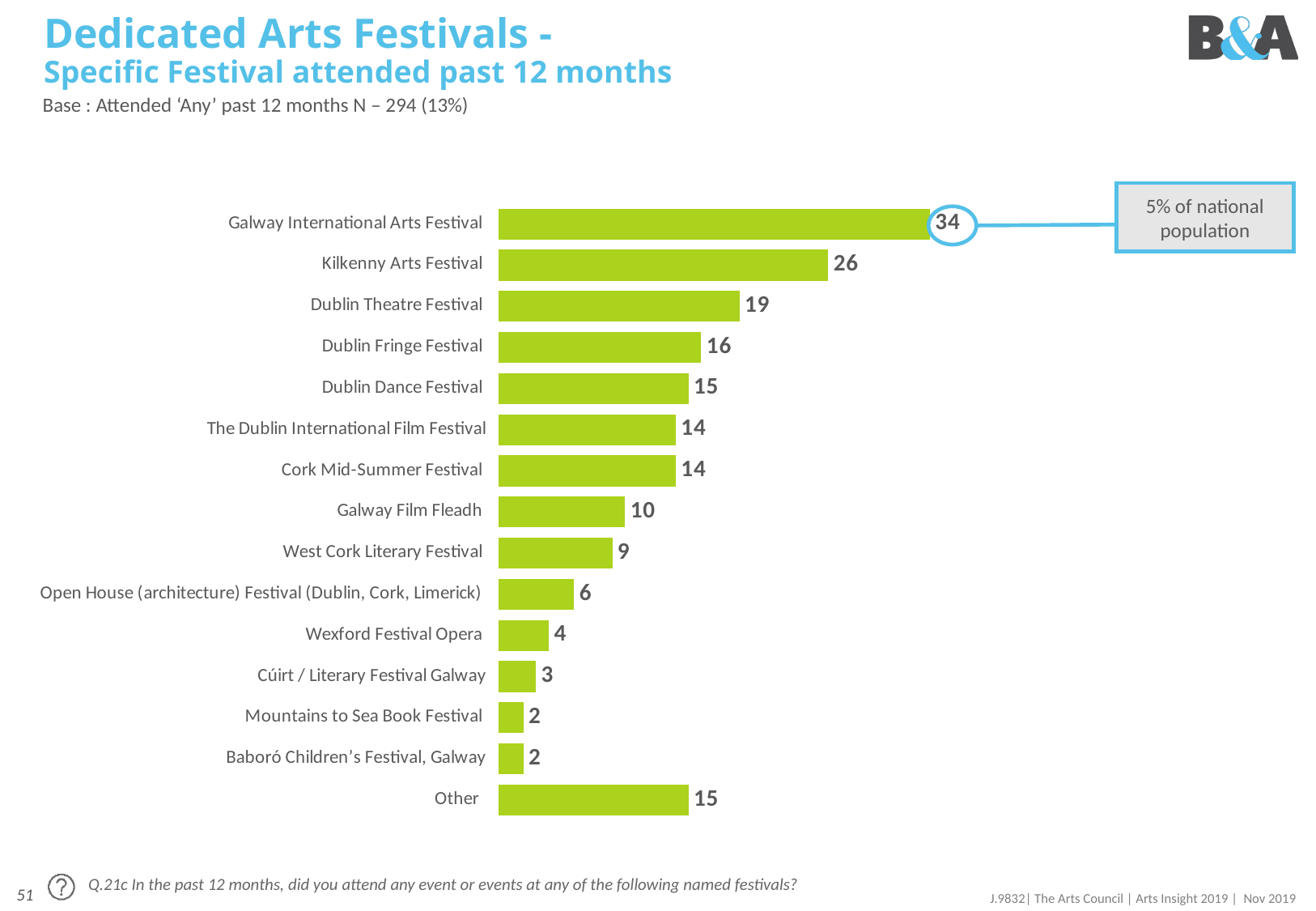
Which festival has the highest value? Galway International Arts Festival What is the value for Kilkenny Arts Festival? 26 How many categories are shown in the chart? 15 What is the value for Wexford Festival Opera? 4 What is the value for Galway International Arts Festival? 34 According to the callout box, what share of the national population does the Galway International Arts Festival value represent? 5% of national population What is the value for Other? 15 What is the difference between the values for Dublin Theatre Festival and Galway Film Fleadh? 9 Which is larger, the value for Dublin Dance Festival or the value for West Cork Literary Festival? Dublin Dance Festival What kind of chart is shown on the slide? Bar chart What is the difference between the values for Galway International Arts Festival and Kilkenny Arts Festival? 8 What is the value for Dublin Fringe Festival? 16